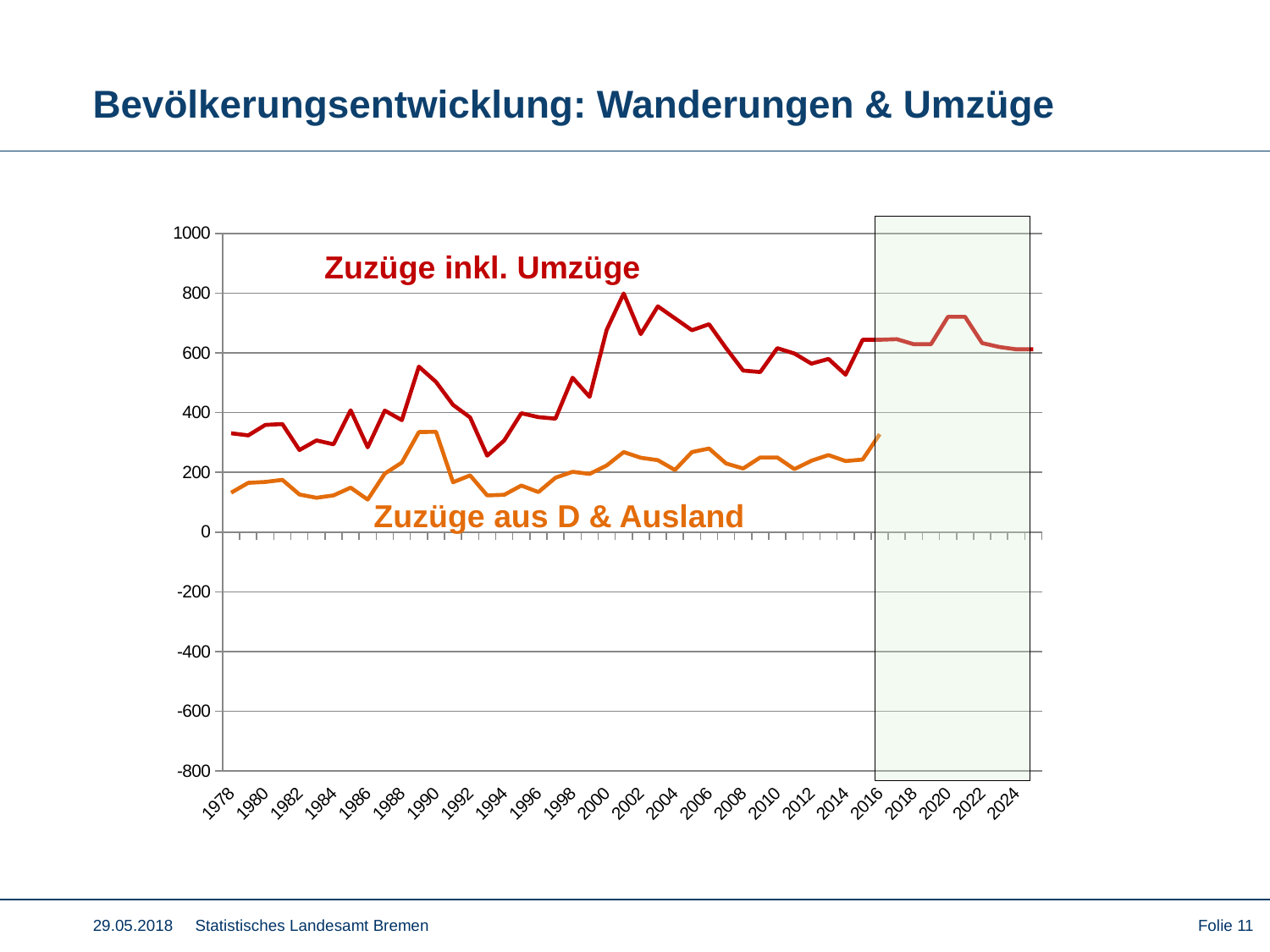
Is the value of 'Zuzüge aus D & Ausland' in 2016 greater or less than 200? greater Does the 'Zuzüge aus D & Ausland' line rise or fall between 1990 and 1994? fall Is the value of 'Zuzüge aus D & Ausland' in 1994 greater or less than 200? less How many data series are plotted in the chart? 2 What kind of chart is shown on the slide? line chart Which series has the higher value in 2010, 'Zuzüge inkl. Umzüge' or 'Zuzüge aus D & Ausland'? Zuzüge inkl. Umzüge Which series is drawn in red? Zuzüge inkl. Umzüge Is the value of 'Zuzüge inkl. Umzüge' in 2020 greater or less than 600? greater What is the title of the slide containing the chart? Bevölkerungsentwicklung: Wanderungen & Umzüge Does the 'Zuzüge inkl. Umzüge' line rise or fall between 1994 and 2000? rise